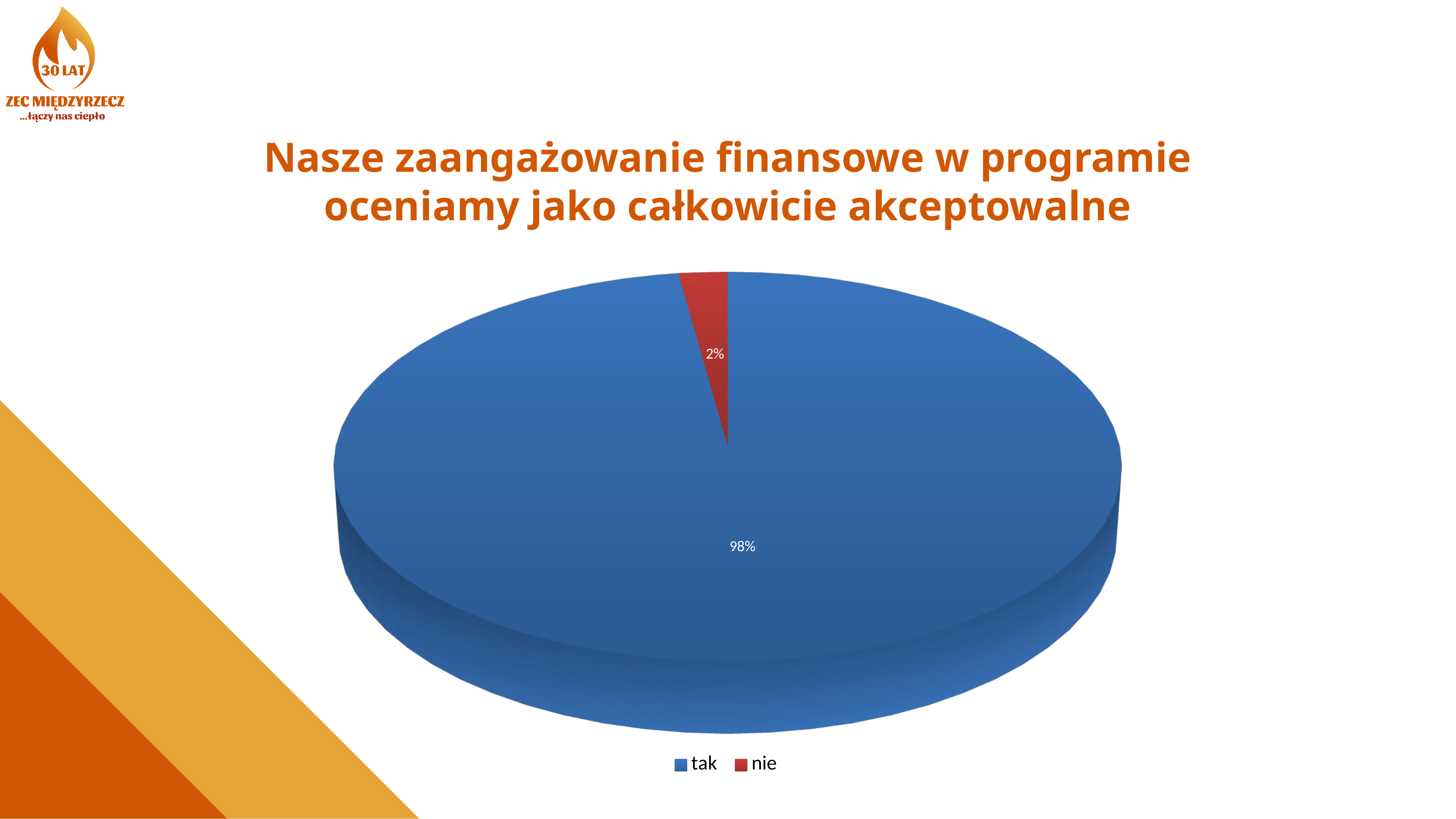
What is the difference in percentage points between the "tak" and "nie" slices? 96 Which slice is larger, "tak" or "nie"? tak Which category has the smallest slice of the pie? nie What share of the pie does "tak" represent? 98% How many entries does the legend list? 2 What share of the pie does "nie" represent? 2% What kind of chart is shown on the slide? pie chart Which category has the largest slice of the pie? tak How many categories does the pie chart show? 2 What colour is the "nie" slice? red What is the title of the chart? Nasze zaangażowanie finansowe w programie oceniamy jako całkowicie akceptowalne